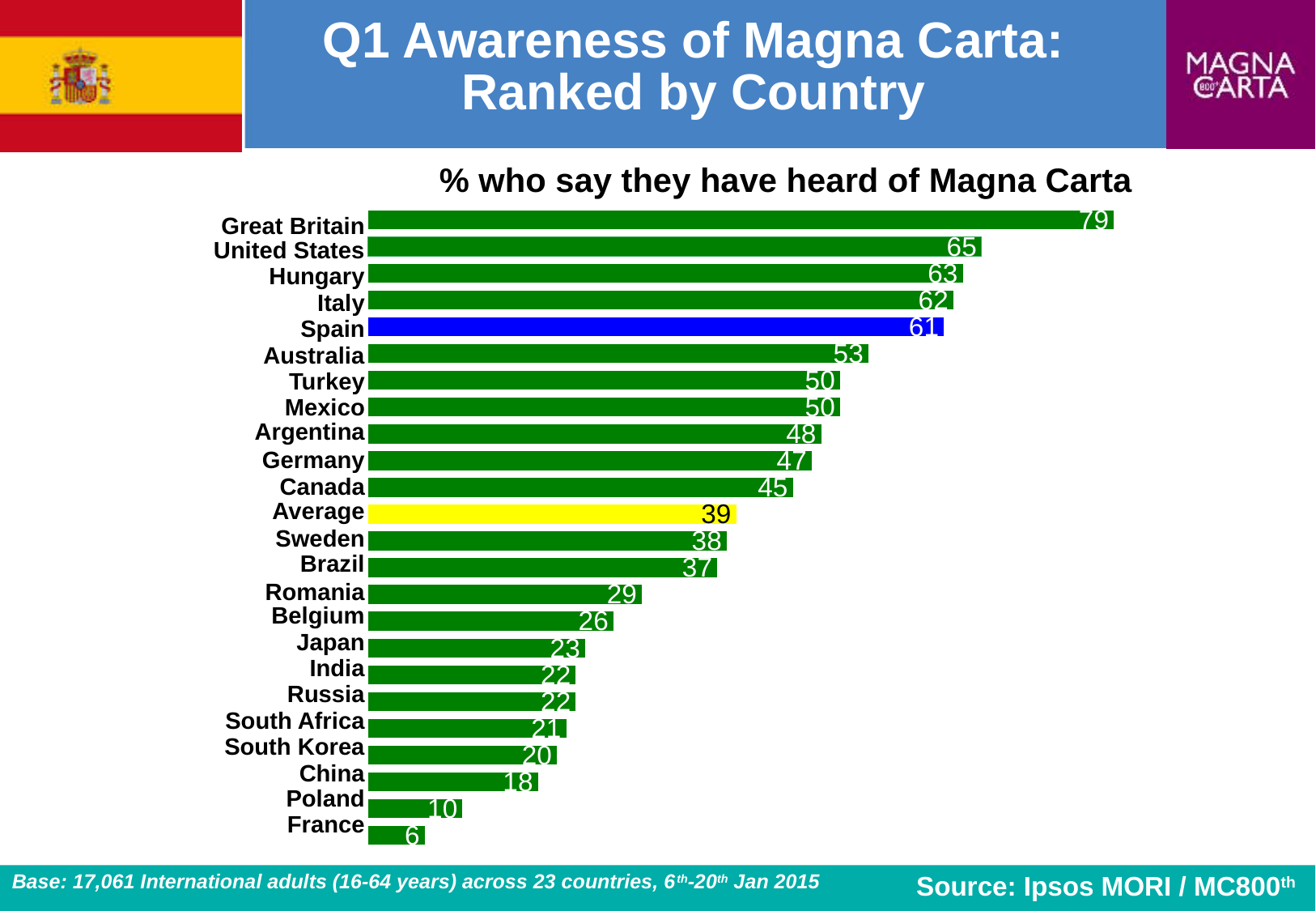
What kind of chart is shown on the slide? Bar chart Which is larger, the value for Australia or the value for Germany? Australia How many countries are shown in the chart (excluding the Average bar)? 23 What is the value for Canada? 45 What is the difference between the values for Great Britain and the United States? 14 Which country has the highest value? Great Britain Which is larger, the value for Poland or the value for China? China Which country has the lowest value? France What colour is the bar for Spain? Blue What is the difference between the values for Spain and the Average? 22 What is the value for Spain? 61 What is the value shown for Average? 39